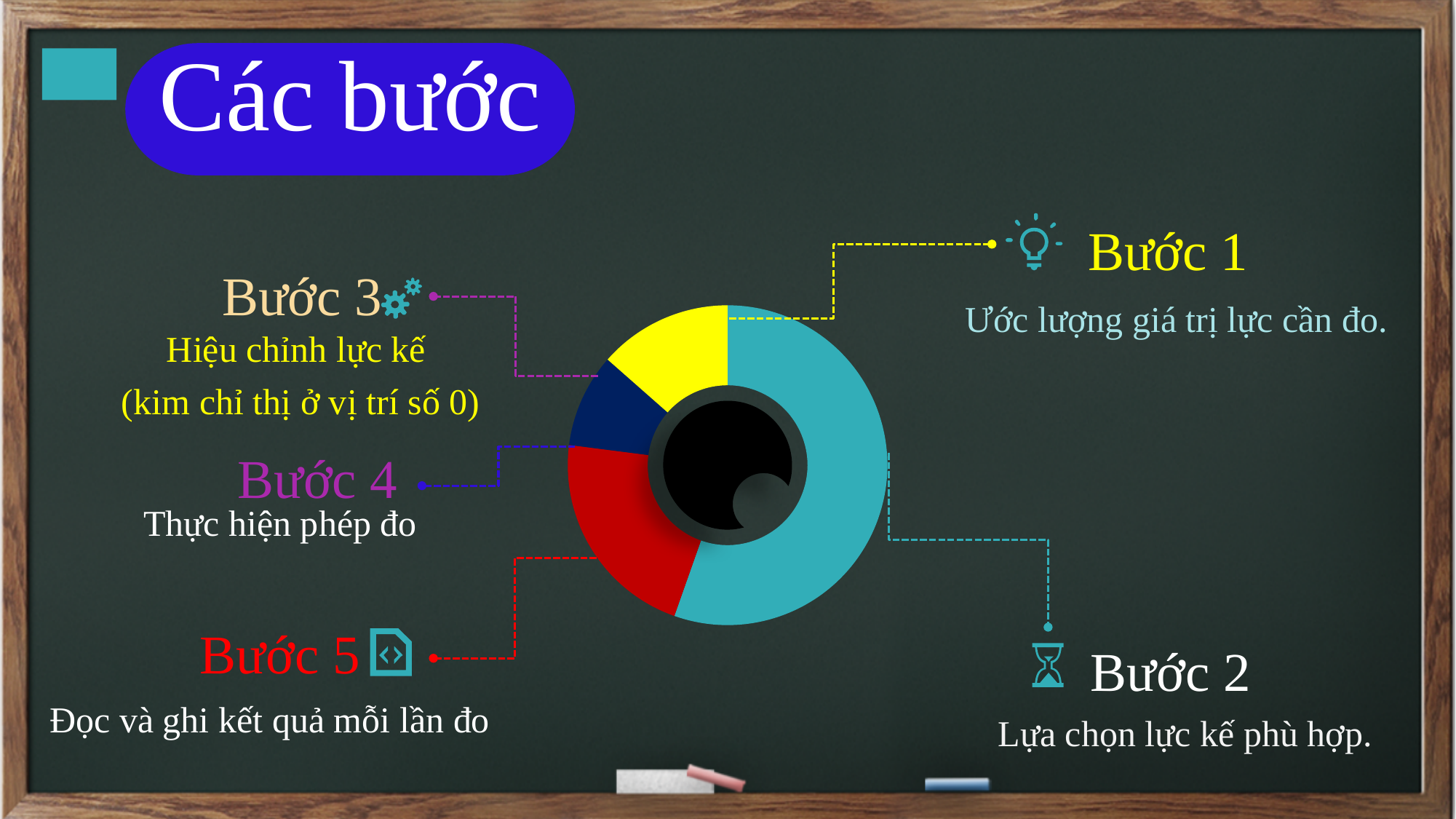
Which step label is connected to the teal slice of the doughnut chart? Bước 2 What is the title of the slide containing the doughnut chart? Các bước Which colour occupies the smallest share of the doughnut chart? Navy blue Which colour occupies the largest share of the doughnut chart? Teal What kind of chart is shown in the centre of the slide? Doughnut (pie) chart Is the teal slice of the doughnut chart larger or smaller than the yellow slice? Larger What text describes Bước 1 next to the doughnut chart? Ước lượng giá trị lực cần đo. Does the teal slice of the doughnut chart cover more or less than half of the ring? More Is the teal slice of the doughnut chart larger or smaller than the red slice? Larger How many steps (Bước) are labelled around the doughnut chart? 5 What text describes Bước 4 next to the doughnut chart? Thực hiện phép đo